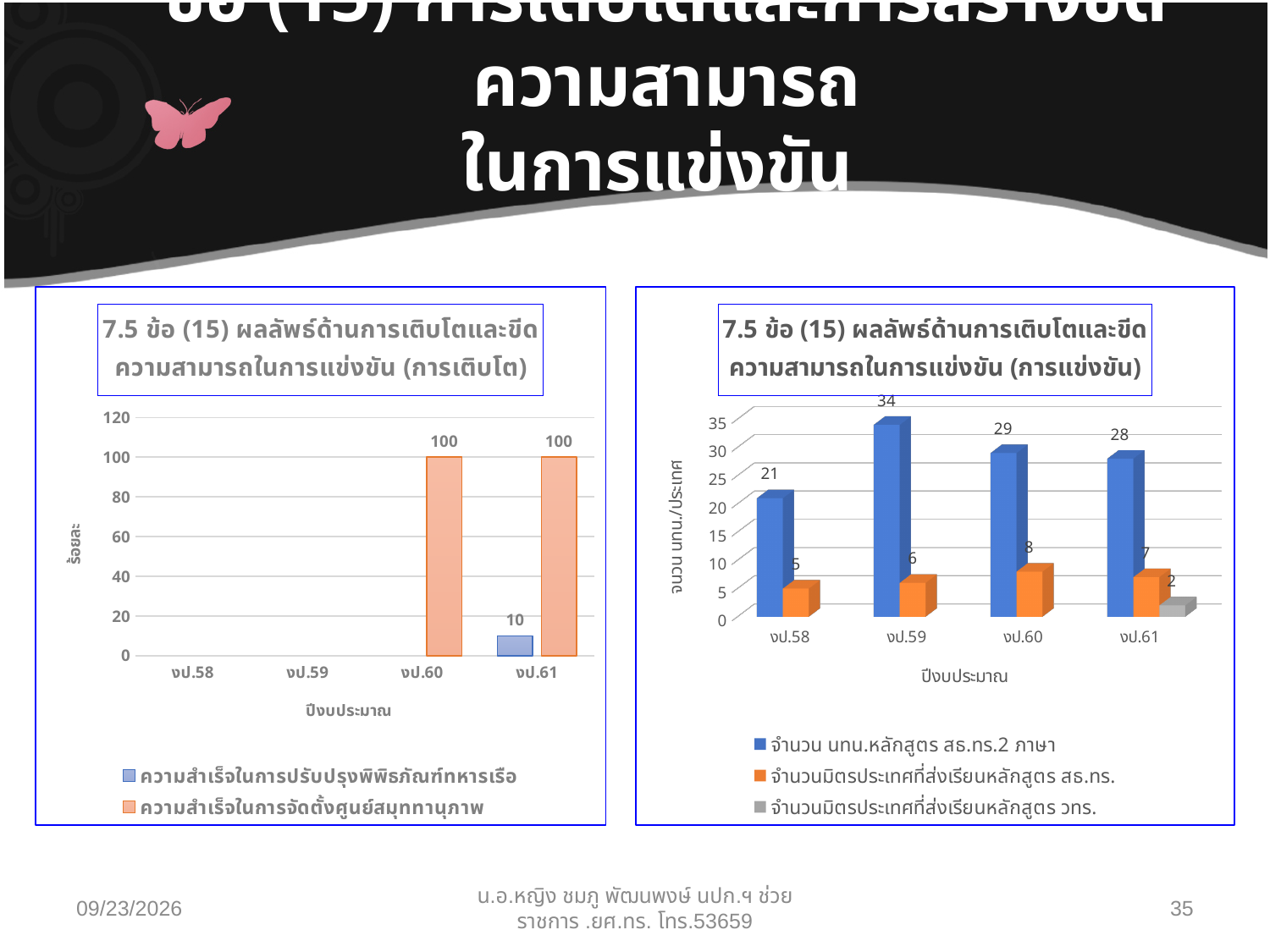
In the right chart (การแข่งขัน), what is the value for จำนวน นทน.หลักสูตร สธ.ทร.2 ภาษา in งป.59? 34 In the left chart (การเติบโต), what is the value for ความสำเร็จในการจัดตั้งศูนย์สมุททานุภาพ in งป.60? 100 In the right chart (การแข่งขัน), what is the value for จำนวนมิตรประเทศที่ส่งเรียนหลักสูตร สธ.ทร. in งป.60? 8 In the left chart (การเติบโต), how many fiscal-year categories are shown on the x axis? 4 In the right chart (การแข่งขัน), how many series does the legend list? 3 In the right chart (การแข่งขัน), which fiscal year has the highest value for จำนวน นทน.หลักสูตร สธ.ทร.2 ภาษา? งป.59 In the left chart (การเติบโต), what is the difference between the two series' values in งป.61? 90 In the left chart (การเติบโต), how many series does the legend list? 2 In the left chart (การเติบโต), what is the value for ความสำเร็จในการปรับปรุงพิพิธภัณฑ์ทหารเรือ in งป.61? 10 What kind of chart is the right chart (การแข่งขัน)? Bar chart In the right chart (การแข่งขัน), what is the difference between จำนวน นทน.หลักสูตร สธ.ทร.2 ภาษา in งป.59 and งป.58? 13 In the right chart (การแข่งขัน), which fiscal year has the lowest value for จำนวน นทน.หลักสูตร สธ.ทร.2 ภาษา? งป.58